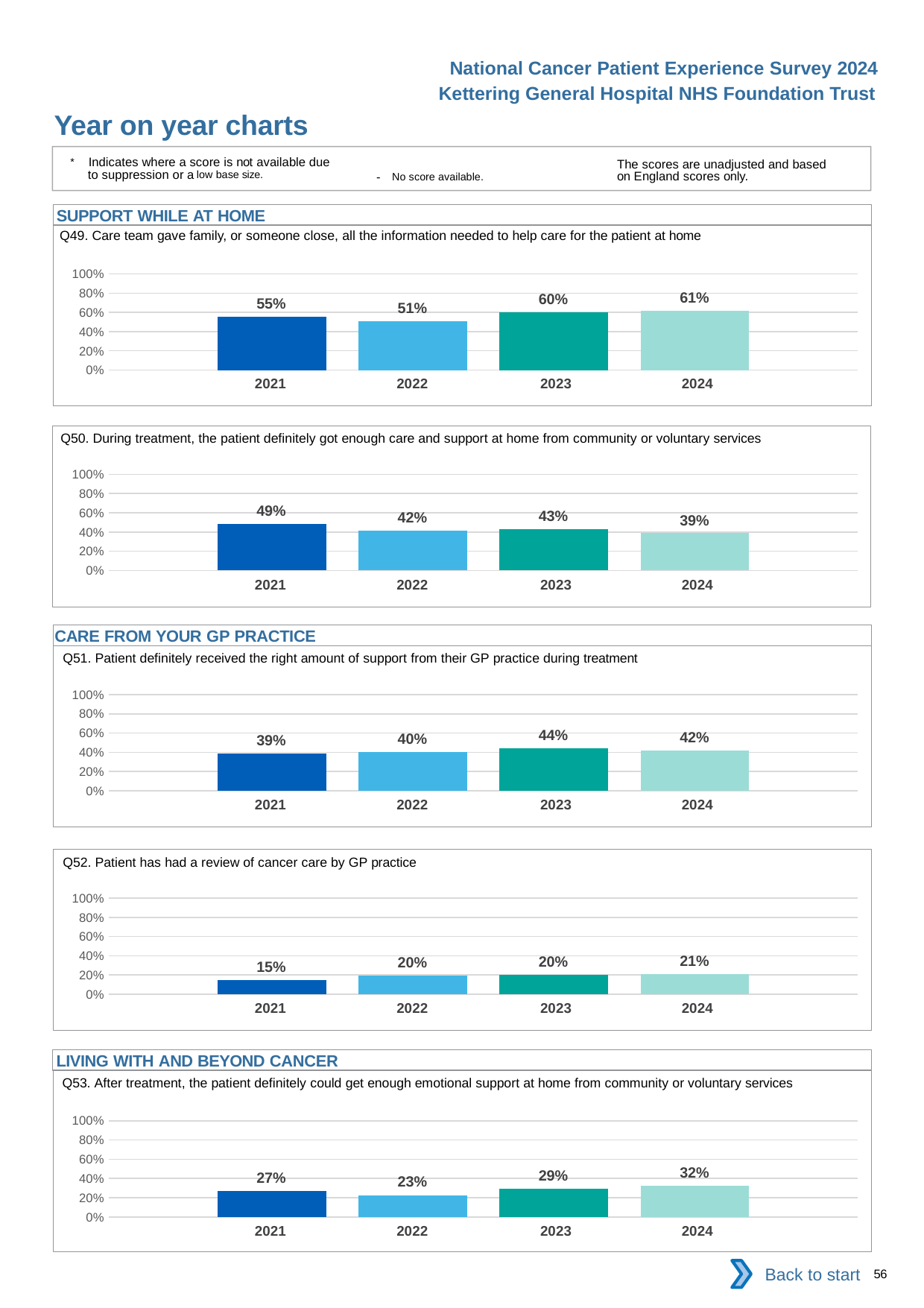
In the Q49 chart, what is the value for 2024? 61% In the Q50 chart, what is the value for 2021? 49% In the Q49 chart, which year has the lowest value? 2022 In the Q52 chart, what is the value for 2021? 15% What kind of chart is the Q53 chart? bar chart In the Q49 chart, is the value for 2023 greater or less than 40%? greater In the Q50 chart, what is the difference between the 2021 and 2024 values? 10 percentage points In the Q52 chart, how many years are plotted? 4 In the Q51 chart, which year has the highest value? 2023 In the Q53 chart, what is the value for 2022? 23% In the Q53 chart, what is the difference between the 2024 and 2023 values? 3 percentage points In the Q51 chart, is the value for 2022 larger or smaller than the value for 2024? smaller